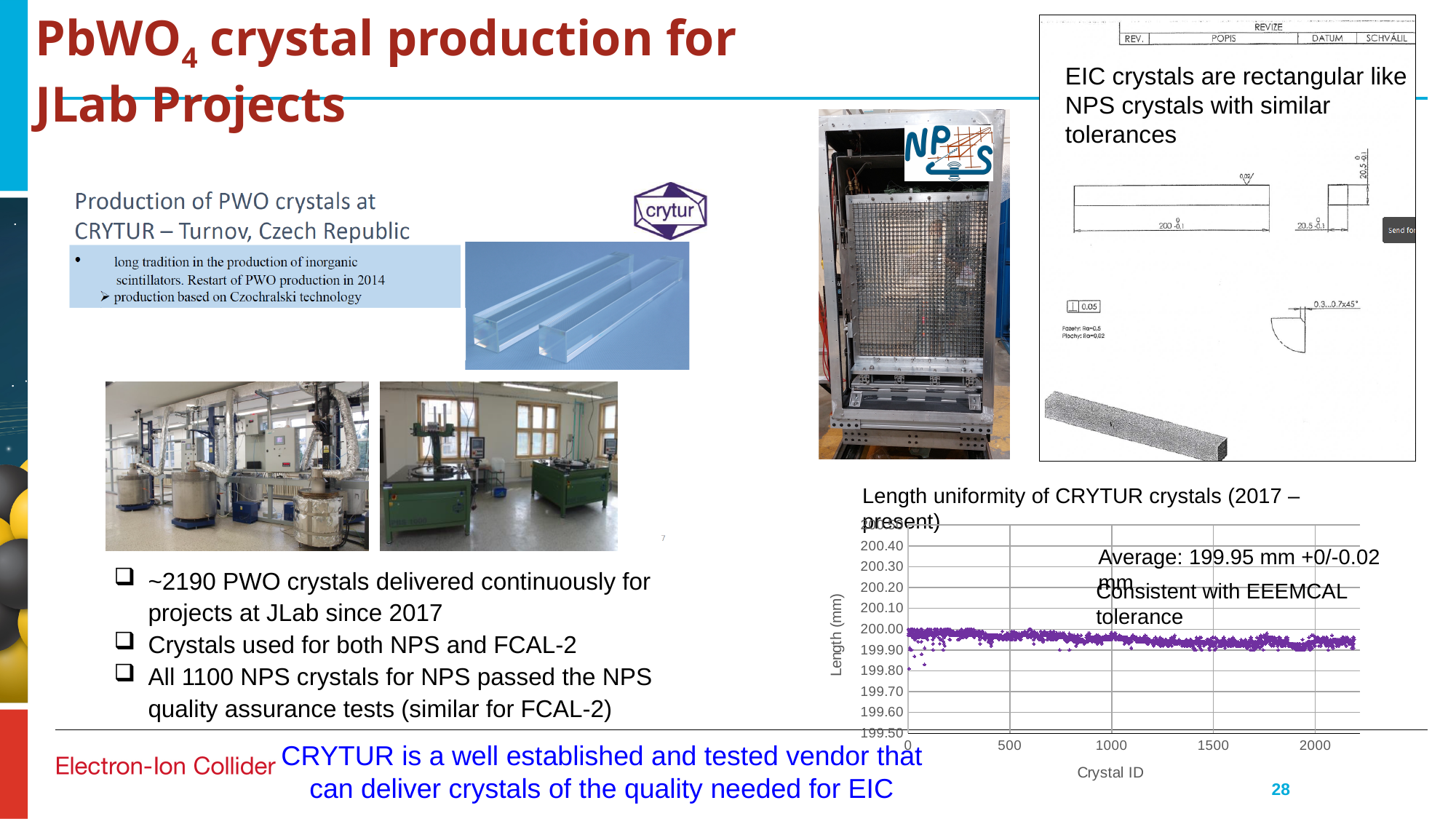
What is the label of the y axis of the length uniformity chart? Length (mm) What is the highest value shown on the y axis of the length uniformity chart? 200.50 What kind of chart is shown at the bottom right of the slide? scatter chart According to the annotation on the length uniformity chart, what is the average crystal length? 199.95 mm +0/-0.02 mm In the length uniformity chart, are the plotted crystal lengths greater or less than 200.10 mm? less In the length uniformity chart, are nearly all plotted crystal lengths greater or less than 199.80 mm? greater In the length uniformity chart, are the plotted crystal lengths greater or less than 200.30 mm? less What is the largest tick value shown on the x axis of the length uniformity chart? 2000 What is the lowest value shown on the y axis of the length uniformity chart? 199.50 What is the title of the chart at the bottom right of the slide? Length uniformity of CRYTUR crystals (2017 – present) In the length uniformity chart, do the crystal lengths rise, fall, or stay roughly flat as Crystal ID increases? roughly flat